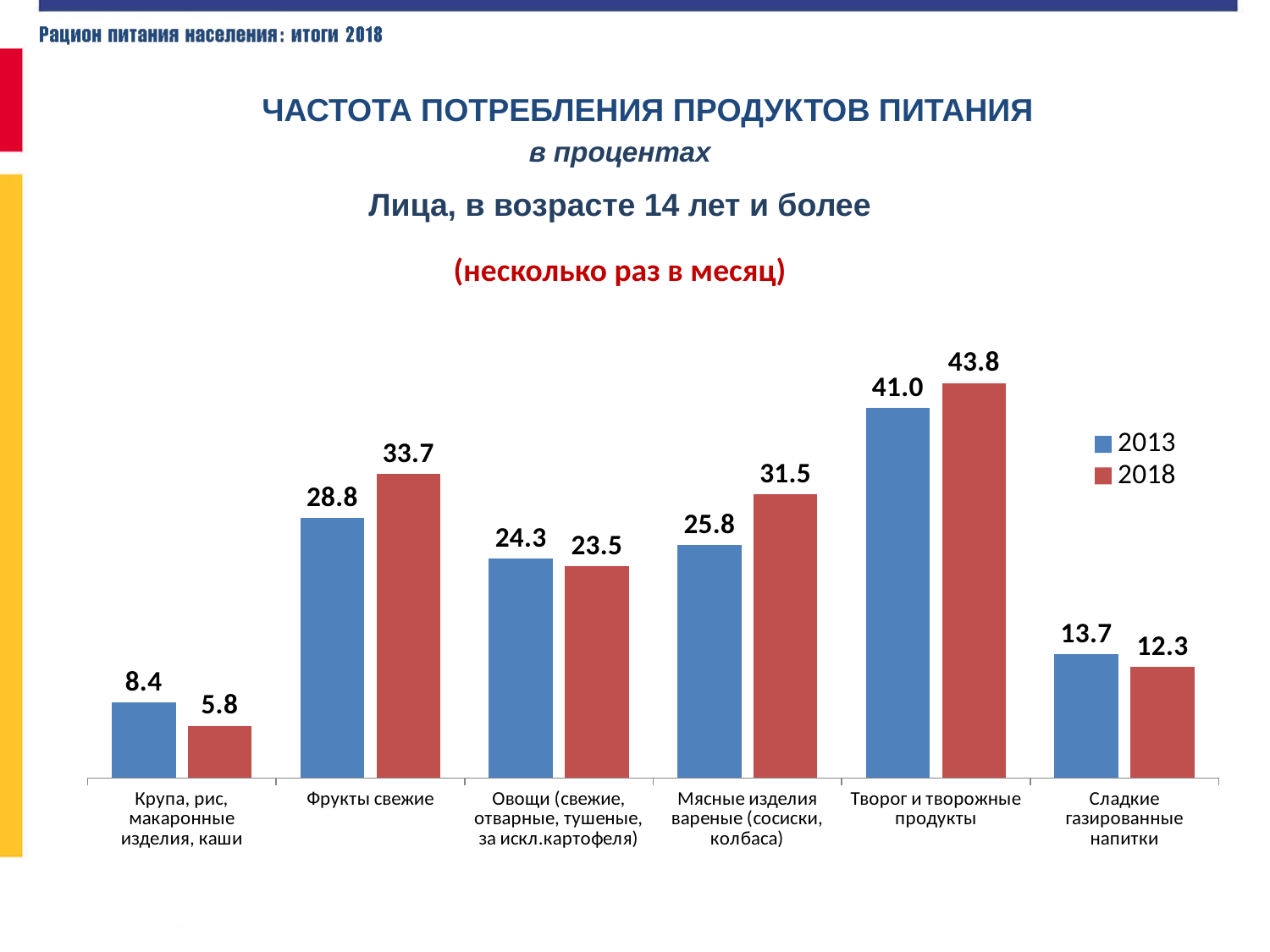
What kind of chart is shown on the slide? Bar chart Which is larger for Овощи (свежие, отварные, тушеные, за искл.картофеля): the 2013 value or the 2018 value? 2013 What is the difference between the 2018 and 2013 values for Мясные изделия вареные (сосиски, колбаса)? 5.7 What is the difference between the 2013 and 2018 values for Сладкие газированные напитки? 1.4 Which category has the highest 2013 value? Творог и творожные продукты Which category has the lowest 2018 value? Крупа, рис, макаронные изделия, каши Which colour represents the 2018 series in the legend? Red How many series does the legend list? 2 How many categories are shown on the x axis? 6 What is the 2018 value for Крупа, рис, макаронные изделия, каши? 5.8 What is the 2013 value for Фрукты свежие? 28.8 What is the 2018 value for Творог и творожные продукты? 43.8